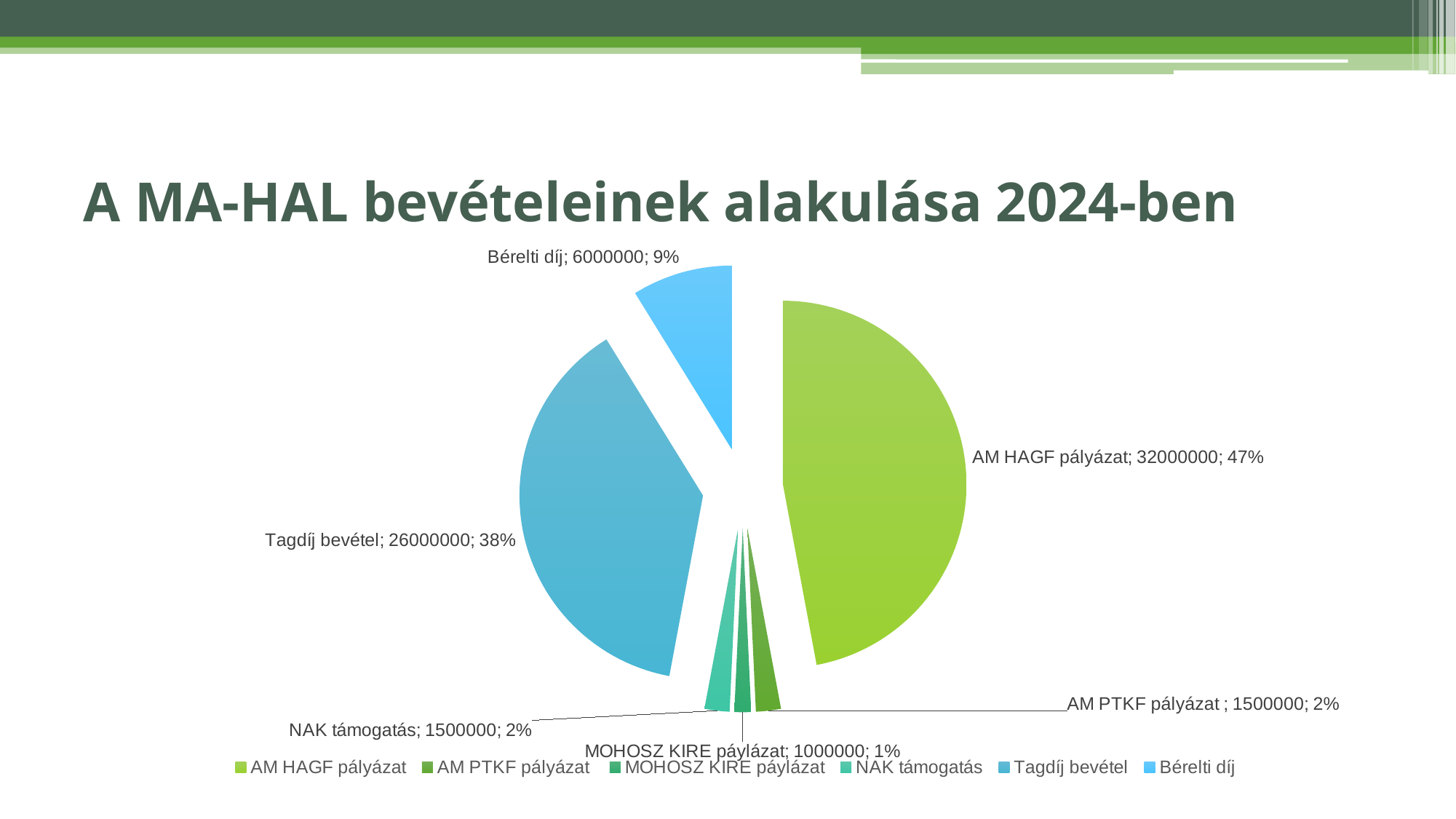
What is the difference between the values for AM HAGF pályázat and Tagdíj bevétel? 6000000 What is the value for MOHOSZ KIRE páylázat? 1000000 Which is larger, the value for Bérelti díj or the value for NAK támogatás? Bérelti díj What kind of chart is shown on the slide? pie chart Which category has the smallest slice? MOHOSZ KIRE páylázat What is the value for AM HAGF pályázat? 32000000 What is the value for Tagdíj bevétel? 26000000 What is the value for Bérelti díj? 6000000 How many categories does the pie chart have? 6 Which category has the largest slice? AM HAGF pályázat What share of the pie does Bérelti díj represent? 9% What share of the pie does Tagdíj bevétel represent? 38%